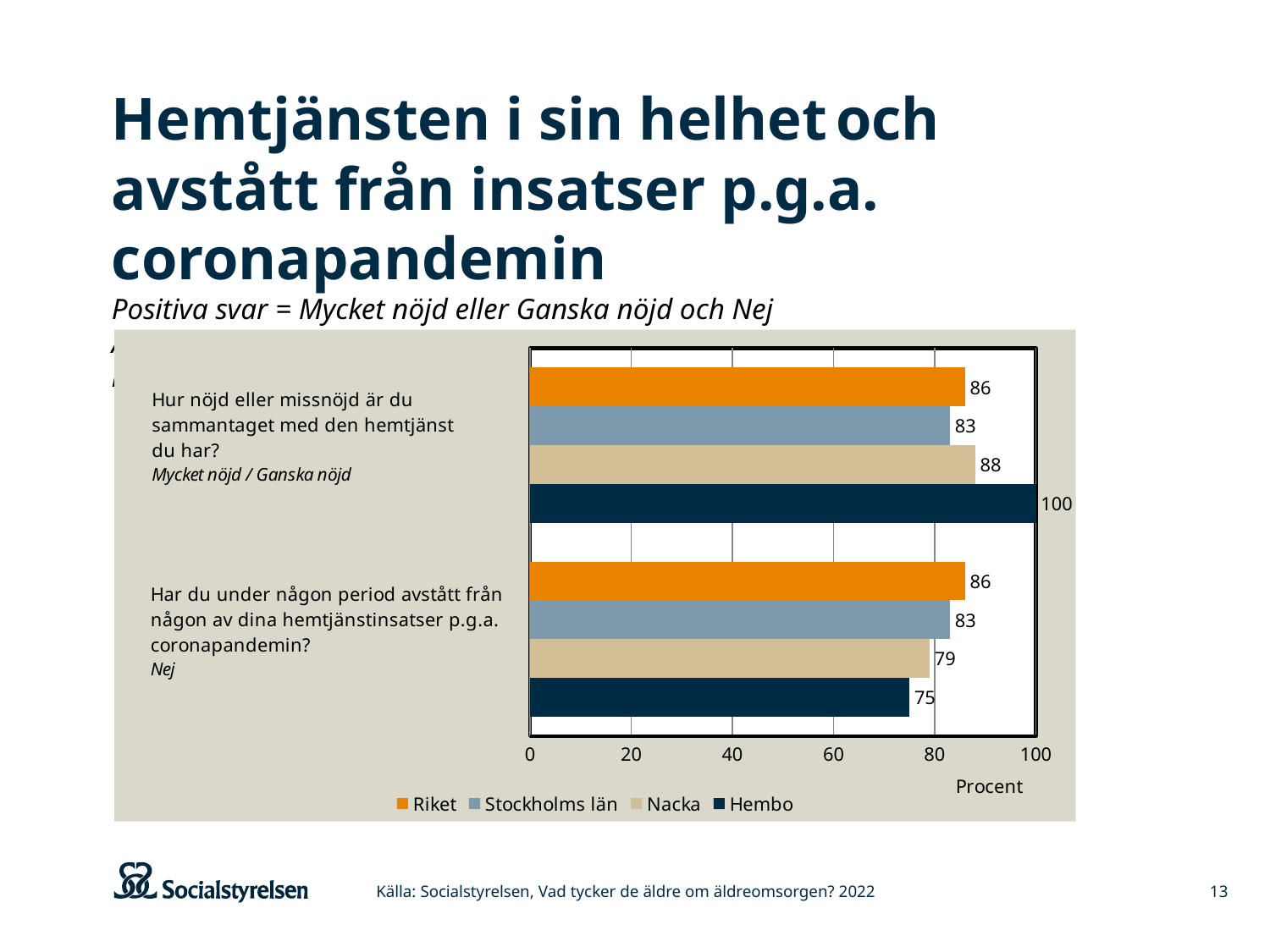
What is the value for Hembo on the question "Hur nöjd eller missnöjd är du sammantaget med den hemtjänst du har?"? 100 How many series does the legend list? 4 Which series has the highest value on the question "Hur nöjd eller missnöjd är du sammantaget med den hemtjänst du har?"? Hembo What kind of chart is shown on the slide? Bar chart Which series has the lowest value on the question "Har du under någon period avstått från någon av dina hemtjänstinsatser p.g.a. coronapandemin?"? Hembo What is the value for Riket on the question "Hur nöjd eller missnöjd är du sammantaget med den hemtjänst du har?"? 86 Is the value for Hembo on the question "Har du under någon period avstått från någon av dina hemtjänstinsatser p.g.a. coronapandemin?" greater or less than 80? less Which is larger on the question "Har du under någon period avstått från någon av dina hemtjänstinsatser p.g.a. coronapandemin?": the value for Riket or the value for Nacka? Riket What is the value for Stockholms län on the question "Har du under någon period avstått från någon av dina hemtjänstinsatser p.g.a. coronapandemin?"? 83 What is the label on the horizontal axis of the chart? Procent What is the value for Nacka on the question "Har du under någon period avstått från någon av dina hemtjänstinsatser p.g.a. coronapandemin?"? 79 What is the difference between the Hembo value and the Nacka value on the question "Hur nöjd eller missnöjd är du sammantaget med den hemtjänst du har?"? 12